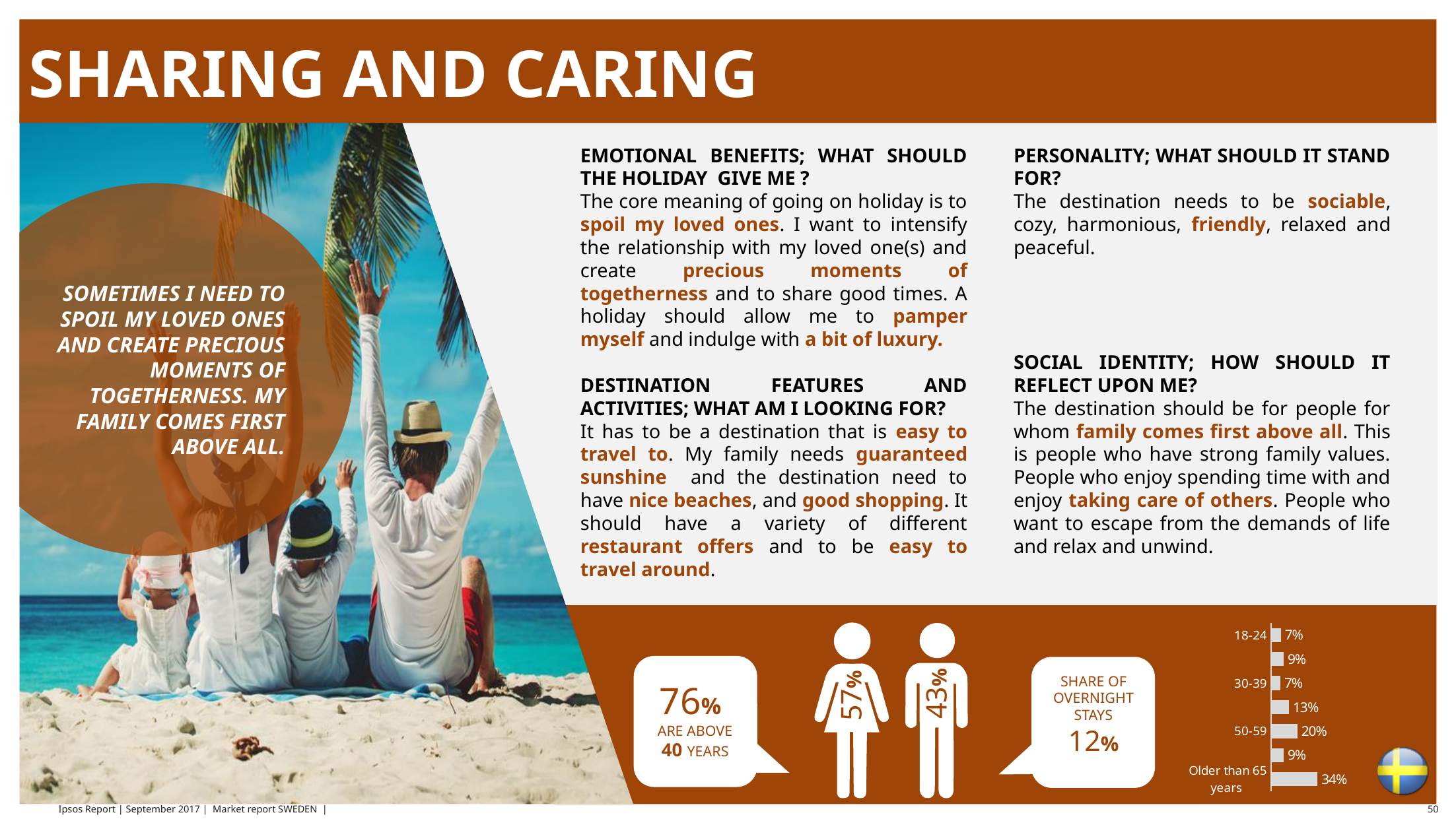
In the age-group bar chart, which is larger: the value for 'Older than 65 years' or the value for 50-59? Older than 65 years In the age-group bar chart at the bottom right, what is the value for the 'Older than 65 years' category? 34% In the age-group bar chart, what is the value for the 18-24 age group? 7% In the age-group bar chart, what is the value for the 50-59 age group? 20% In the age-group bar chart, which is larger: the value for 50-59 or the value for 30-39? 50-59 In the age-group bar chart, which labelled age group has the highest value? Older than 65 years How many bars are plotted in the age-group bar chart at the bottom right? 7 What type of chart is the age-group chart at the bottom right of the slide? Bar chart In the age-group bar chart, what is the difference between the 50-59 value and the 18-24 value? 13 percentage points What colour are the bars in the age-group bar chart? Light grey In the age-group bar chart, what is the difference between the 'Older than 65 years' value and the 50-59 value? 14 percentage points In the age-group bar chart, what is the value for the 30-39 age group? 7%